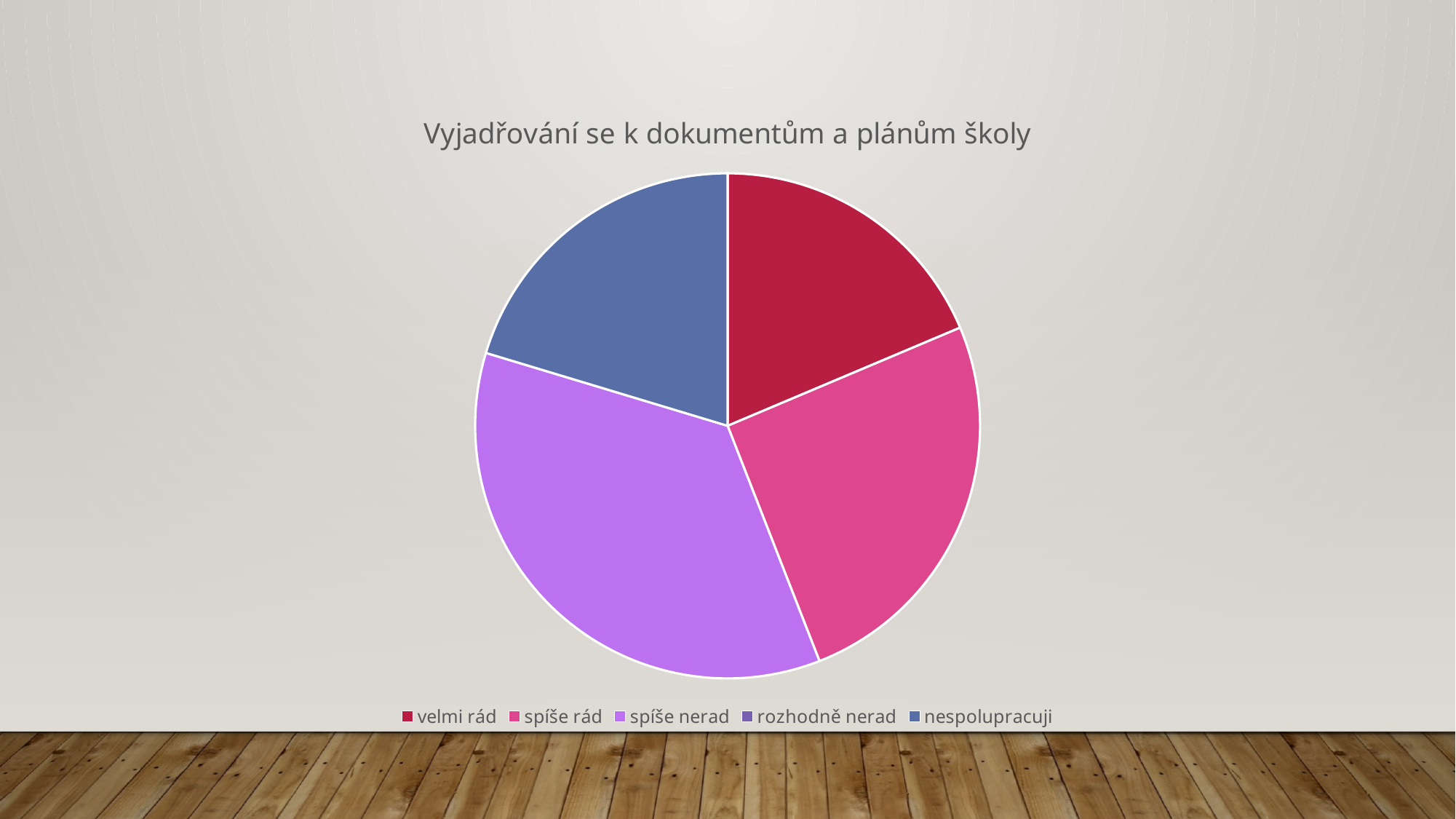
What is the title of the chart? Vyjadřování se k dokumentům a plánům školy Which category has the largest slice of the pie? spíše nerad How many entries does the chart's legend list? 5 Which slice is larger, spíše nerad or velmi rád? spíše nerad Which slice is larger, spíše nerad or spíše rád? spíše nerad What colour is the slice for spíše nerad? purple What kind of chart is shown on the slide? pie chart